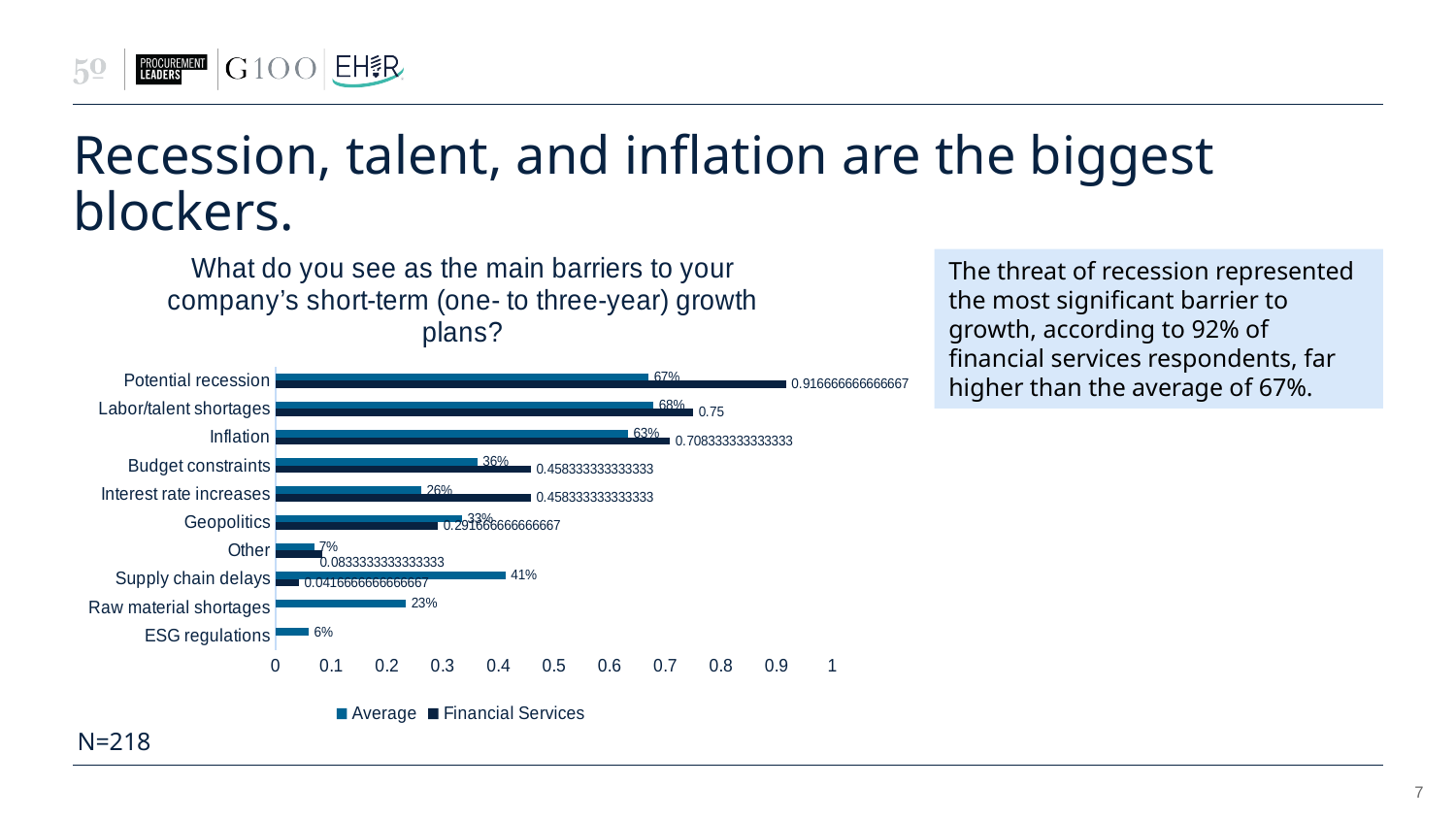
Is the Financial Services value for Potential recession greater or less than 0.9? greater What is the Average value for Potential recession? 67% Which category has the highest Financial Services value? Potential recession What is the difference between the Average values for Potential recession and Budget constraints? 31 percentage points What kind of chart is shown on the slide? Bar chart What are the two series named in the legend? Average and Financial Services Which has the larger Average value, Geopolitics or Interest rate increases? Geopolitics How many categories are shown on the chart? 10 What is the Average value for Supply chain delays? 41% What is the Financial Services value for Labor/talent shortages? 0.75 Which category has the lowest Average value? ESG regulations How many series does the legend list? 2